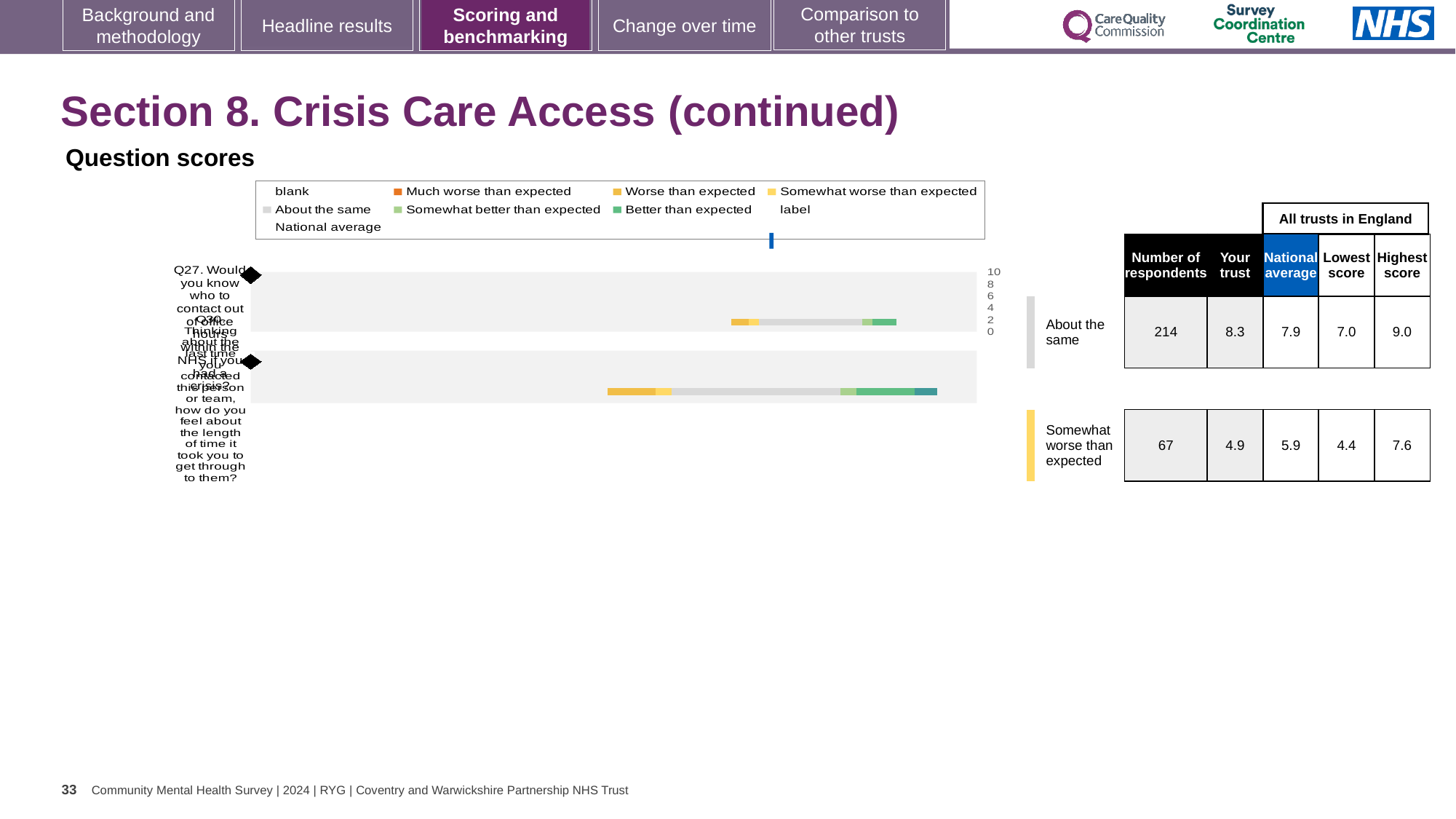
What is the highest value shown on the chart's score axis? 10 What is the difference between the trust's score and the national average for Q30? 1.0 For Q27, is the trust's score higher or lower than the national average? higher What is the difference between the highest and lowest scores across all trusts for Q27? 2.0 How many questions (bars) are plotted in the question scores chart? 2 What is the lowest score across all trusts in England for Q30? 4.4 What is the highest score across all trusts in England for Q27? 9.0 What is the national average score for Q30 in the table beside the chart? 5.9 What is the 'Your trust' score for Q27 in the table beside the chart? 8.3 According to the table beside the chart, how many respondents answered Q27? 214 Which benchmark category is Q30 placed in, as labelled beside the chart? Somewhat worse than expected What kind of chart is used to show the question scores on this slide? bar chart